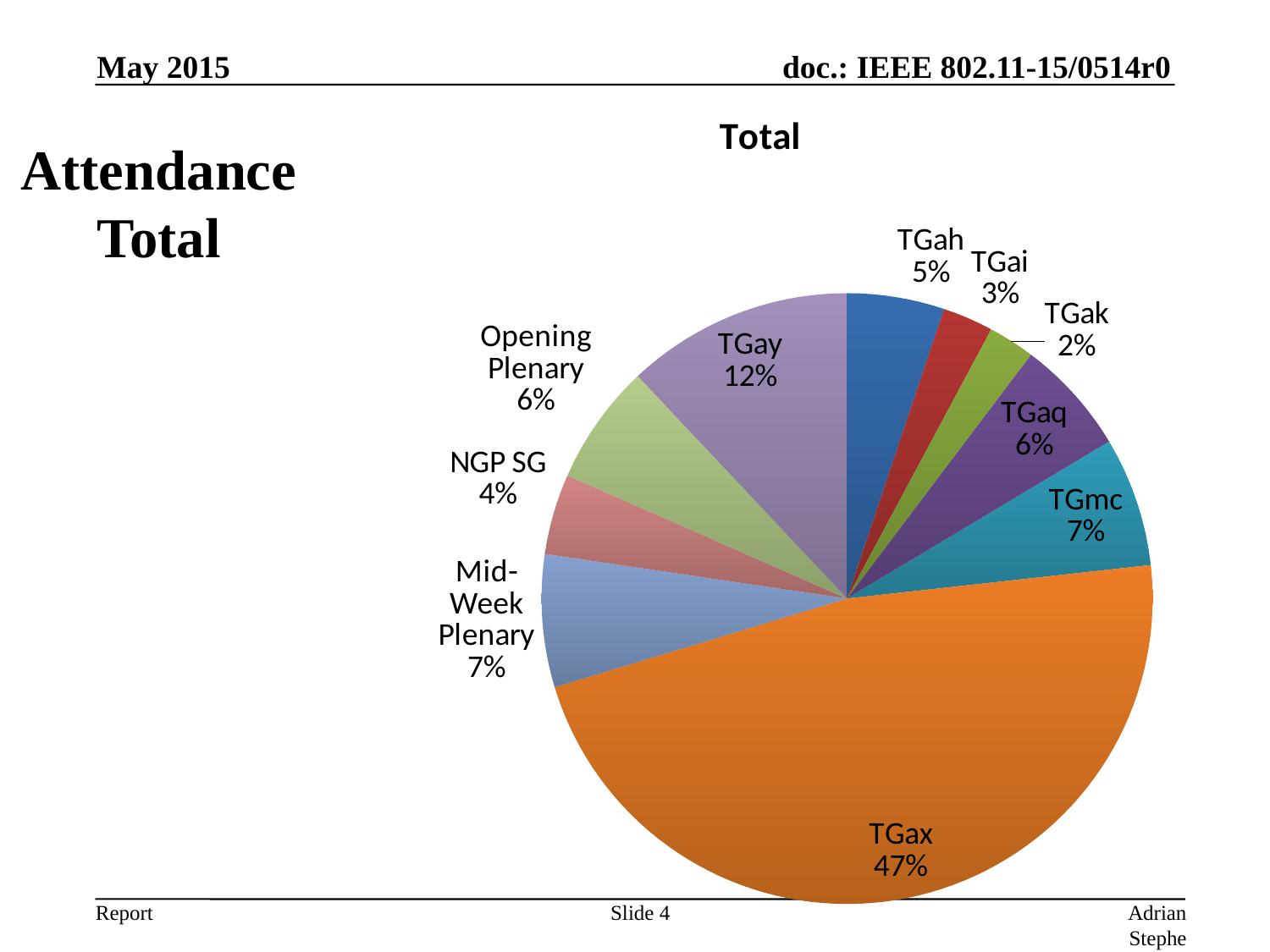
What share of the pie does TGay have? 12% What share of the pie does TGax have? 47% What share of the pie does TGak have? 2% Which slice of the pie is the smallest? TGak Which is larger, the share for TGmc or the share for TGah? TGmc What is the difference in percentage points between the TGay share and the TGaq share? 6% How many slices does the pie chart have? 10 What kind of chart is shown on the slide? pie chart Which slice of the pie is the largest? TGax What is the title of the chart? Total